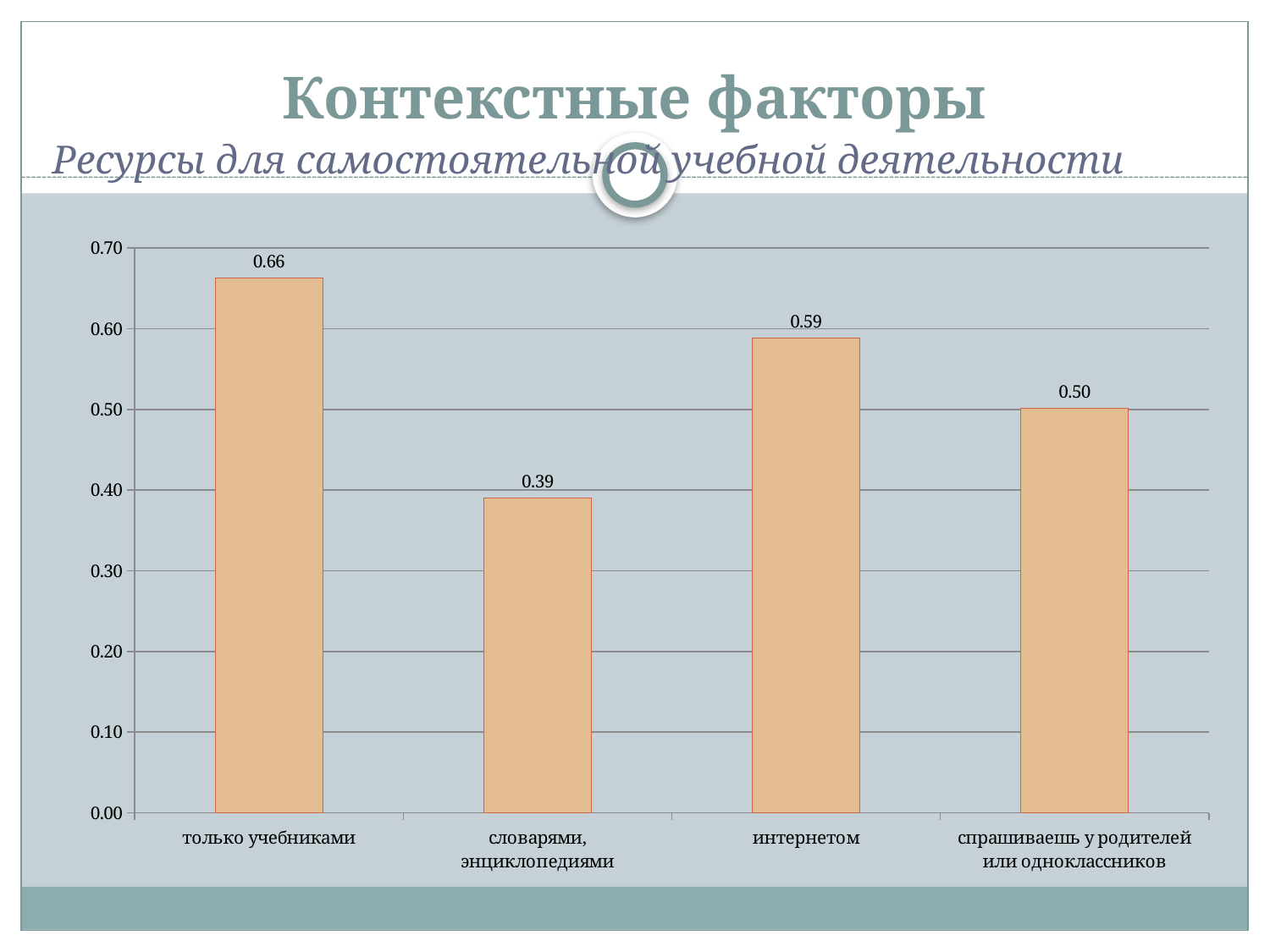
What is the difference between the values for "только учебниками" and "интернетом"? 0.07 Which is larger, the value for "интернетом" or the value for "спрашиваешь у родителей или одноклассников"? интернетом What is the value for "только учебниками"? 0.66 What is the value for "спрашиваешь у родителей или одноклассников"? 0.50 How many categories are shown on the chart? 4 What kind of chart is shown on the slide? bar chart What is the value for "словарями, энциклопедиями"? 0.39 What is the value for "интернетом"? 0.59 Which category has the highest value? только учебниками What is the difference between the values for "интернетом" and "словарями, энциклопедиями"? 0.20 Is the value for "словарями, энциклопедиями" greater or less than 0.40? less Which category has the lowest value? словарями, энциклопедиями